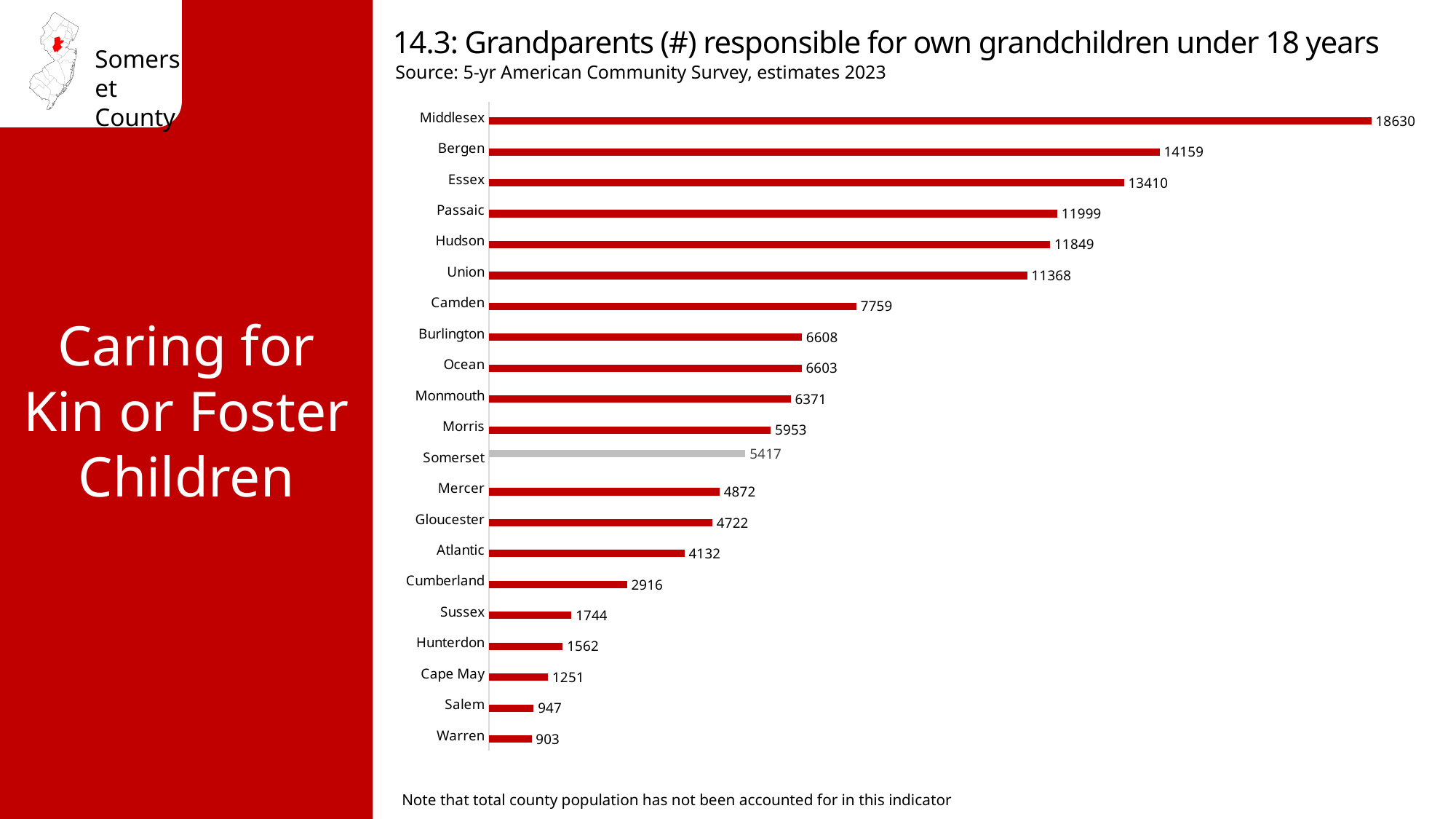
What is the difference between the values for Somerset and Mercer? 545 What is the difference between the values for Bergen and Essex? 749 Which county has the highest value? Middlesex Which is larger, the value for Sussex or the value for Hunterdon? Sussex Which county's bar is coloured grey instead of red? Somerset Which county has the lowest value? Warren What is the value for Cumberland? 2916 Which is larger, the value for Camden or the value for Burlington? Camden What is the value for Middlesex? 18630 What is the value for Somerset? 5417 How many counties are shown in the chart? 21 What kind of chart is shown on the slide? Bar chart